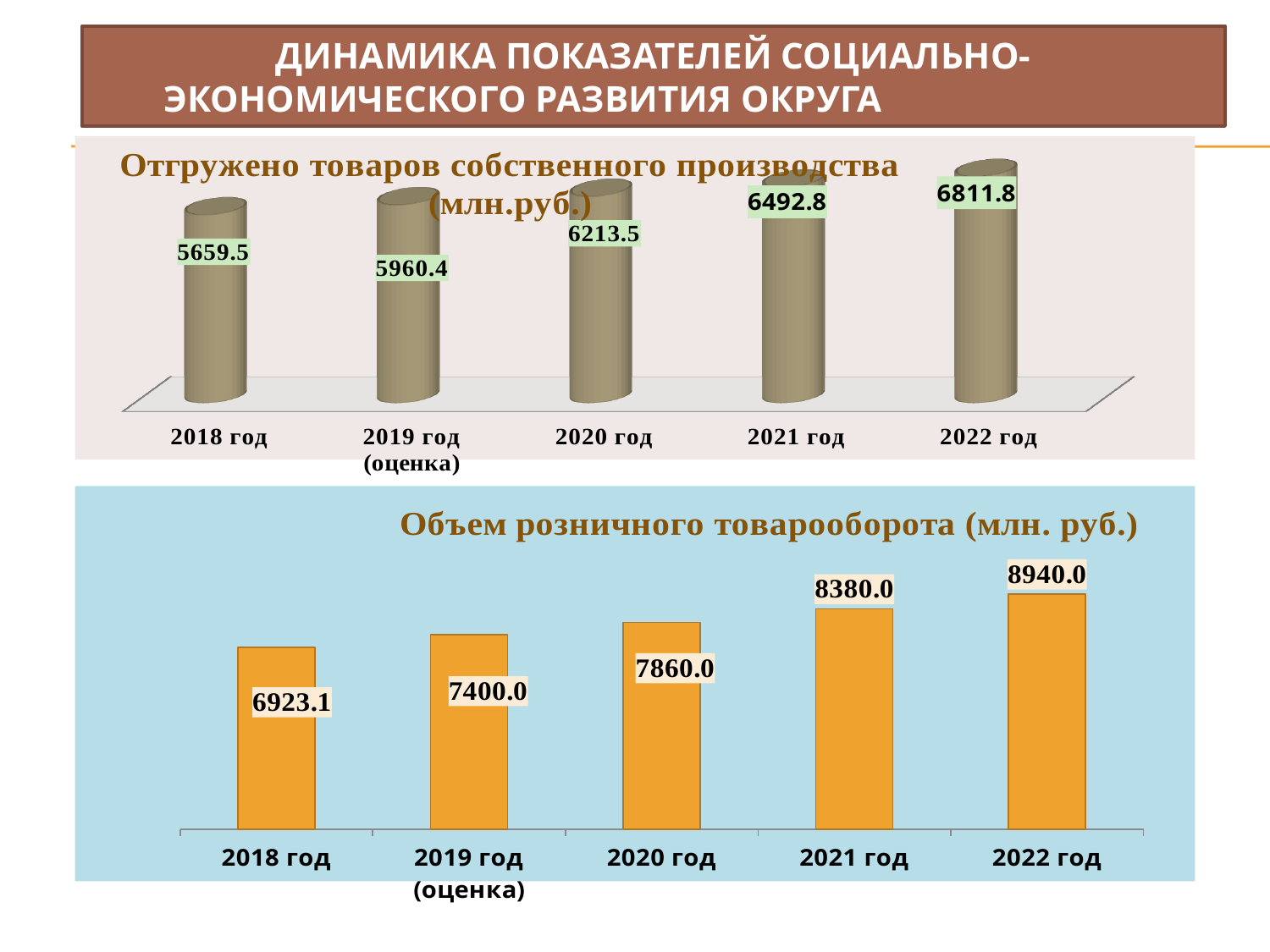
In the bottom chart (Объем розничного товарооборота), what is the difference between the 2022 год and 2021 год values? 560.0 In the top chart (Отгружено товаров собственного производства), do the values rise or fall from 2018 to 2022? rise In the bottom chart (Объем розничного товарооборота), what is the value for 2021 год? 8380.0 What type of chart is the bottom chart (Объем розничного товарооборота)? bar chart In the bottom chart (Объем розничного товарооборота), which year has the lowest value? 2018 год In the top chart (Отгружено товаров собственного производства), what is the difference between the 2022 год and 2018 год values? 1152.3 In the bottom chart (Объем розничного товарооборота), what is the value for 2018 год? 6923.1 How many years are shown in the bottom chart (Объем розничного товарооборота)? 5 In the top chart (Отгружено товаров собственного производства), what is the value for 2020 год? 6213.5 In the top chart (Отгружено товаров собственного производства), what is the value for 2018 год? 5659.5 In the top chart (Отгружено товаров собственного производства), which year has the highest value? 2022 год In the bottom chart (Объем розничного товарооборота), which is larger, the value for 2019 год or 2020 год? 2020 год